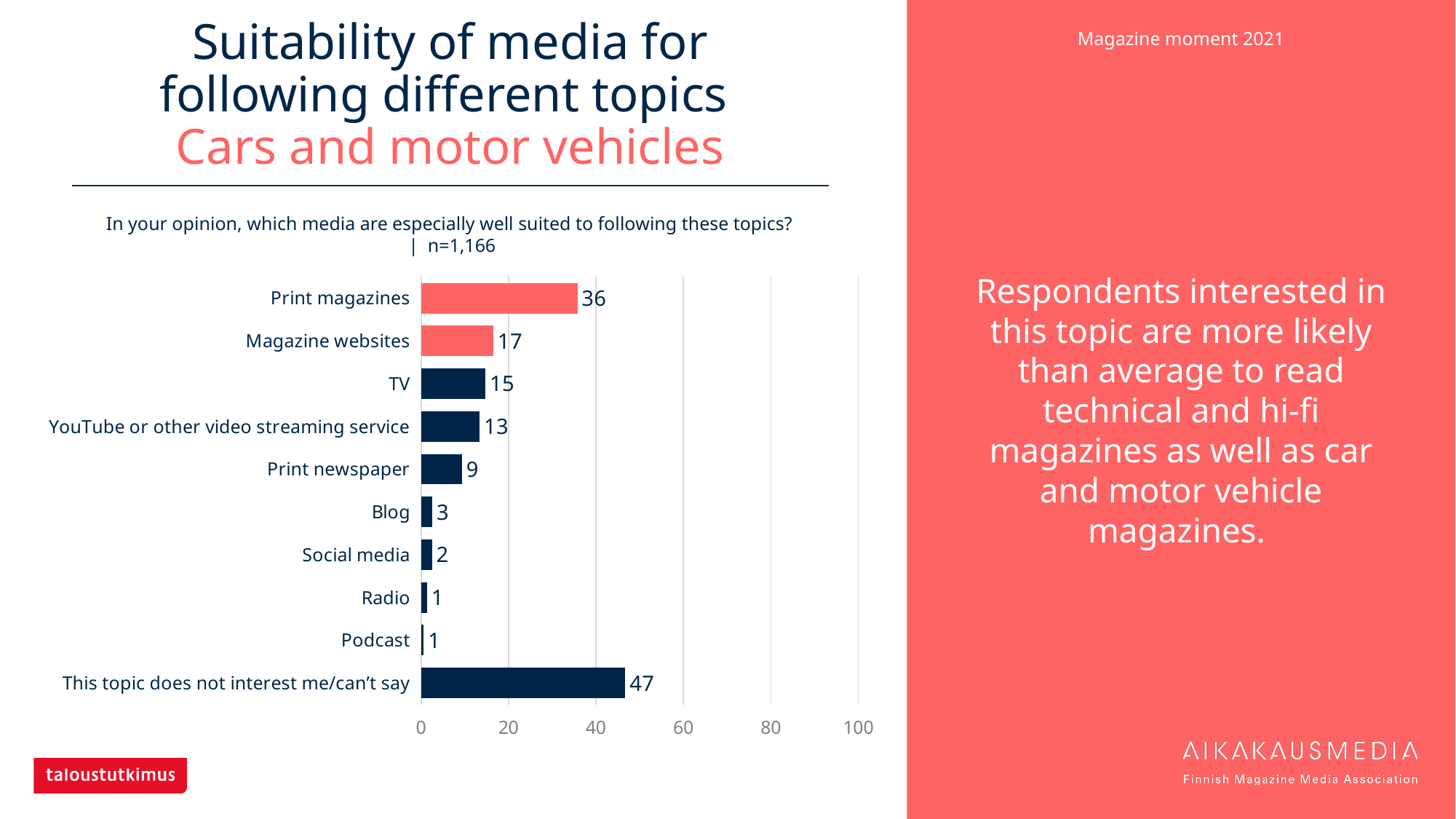
How many categories are shown on the chart? 10 Which media category (excluding the 'does not interest me/can't say' option) has the highest value? Print magazines What is the difference between the values for Print magazines and Magazine websites? 19 What kind of chart is shown on the slide? Bar chart What is the value for YouTube or other video streaming service? 13 What is the value for Print newspaper? 9 What is the sample size (n) stated above the chart? n=1,166 Is the value for 'This topic does not interest me/can't say' greater or less than 40? greater Which is larger, the value for TV or the value for Print newspaper? TV What is the value for Print magazines? 36 Which category has the highest value? This topic does not interest me/can't say What is the difference between the values for TV and Social media? 13